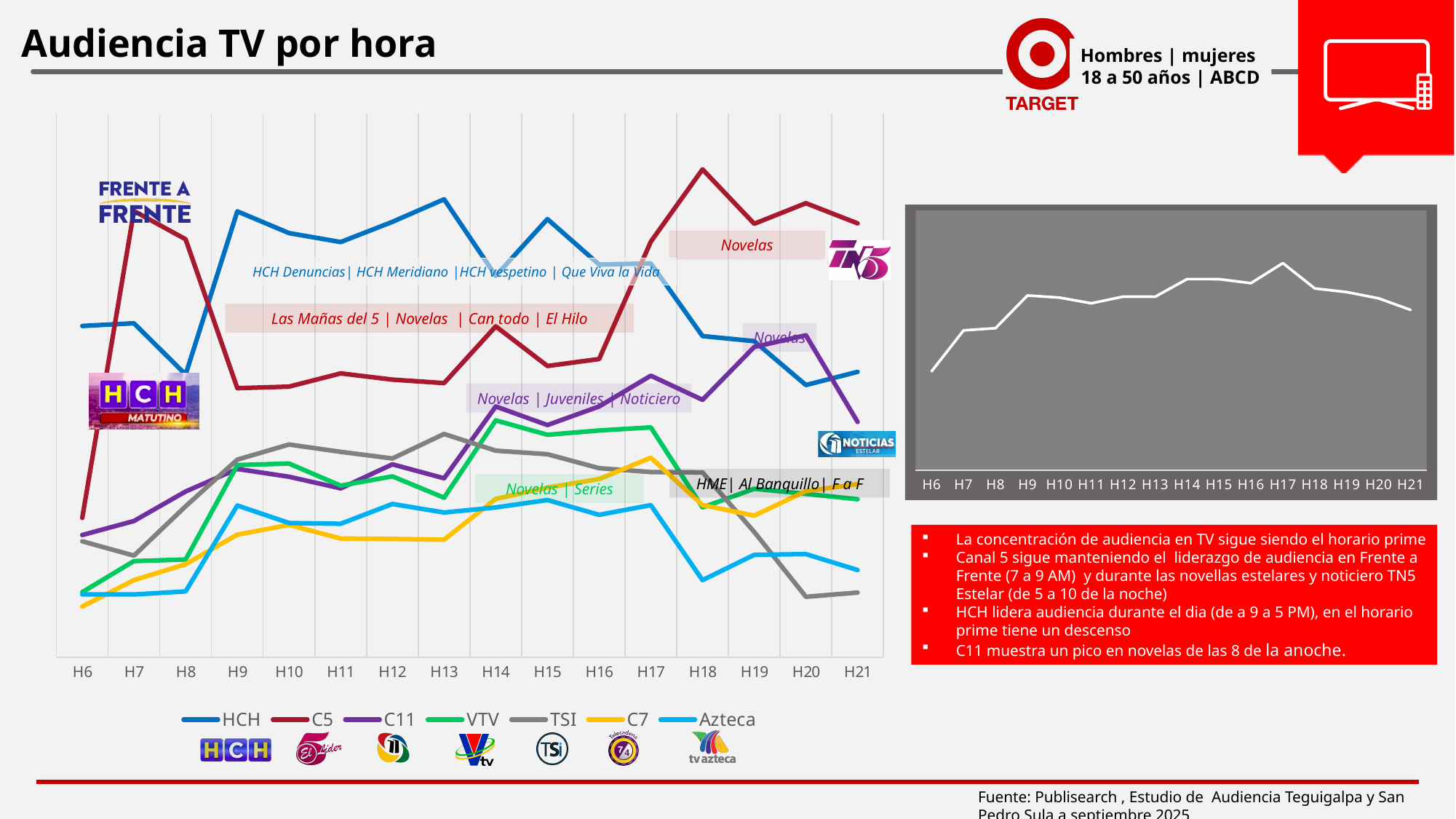
In the left chart, does the TSI line rise or fall from H17 to H20? Fall In the left chart, which series has the lowest value at H21? TSI In the left chart, which series has the lowest value at H6? C7 In the left chart, which series has the highest value at H18? C5 How many series does the legend of the left chart list? 7 In the small chart on the right, at which hour does the line reach its highest point? H17 What kind of chart is the large chart on the left of the slide? Line chart In the left chart, which series has the highest value at H9? HCH How many hour categories are shown on the x axis of the left chart? 16 In the left chart, at H7, which is higher: C5 or HCH? C5 What is the title of the slide's main chart? Audiencia TV por hora In the left chart, at H13, which is higher: HCH or C5? HCH